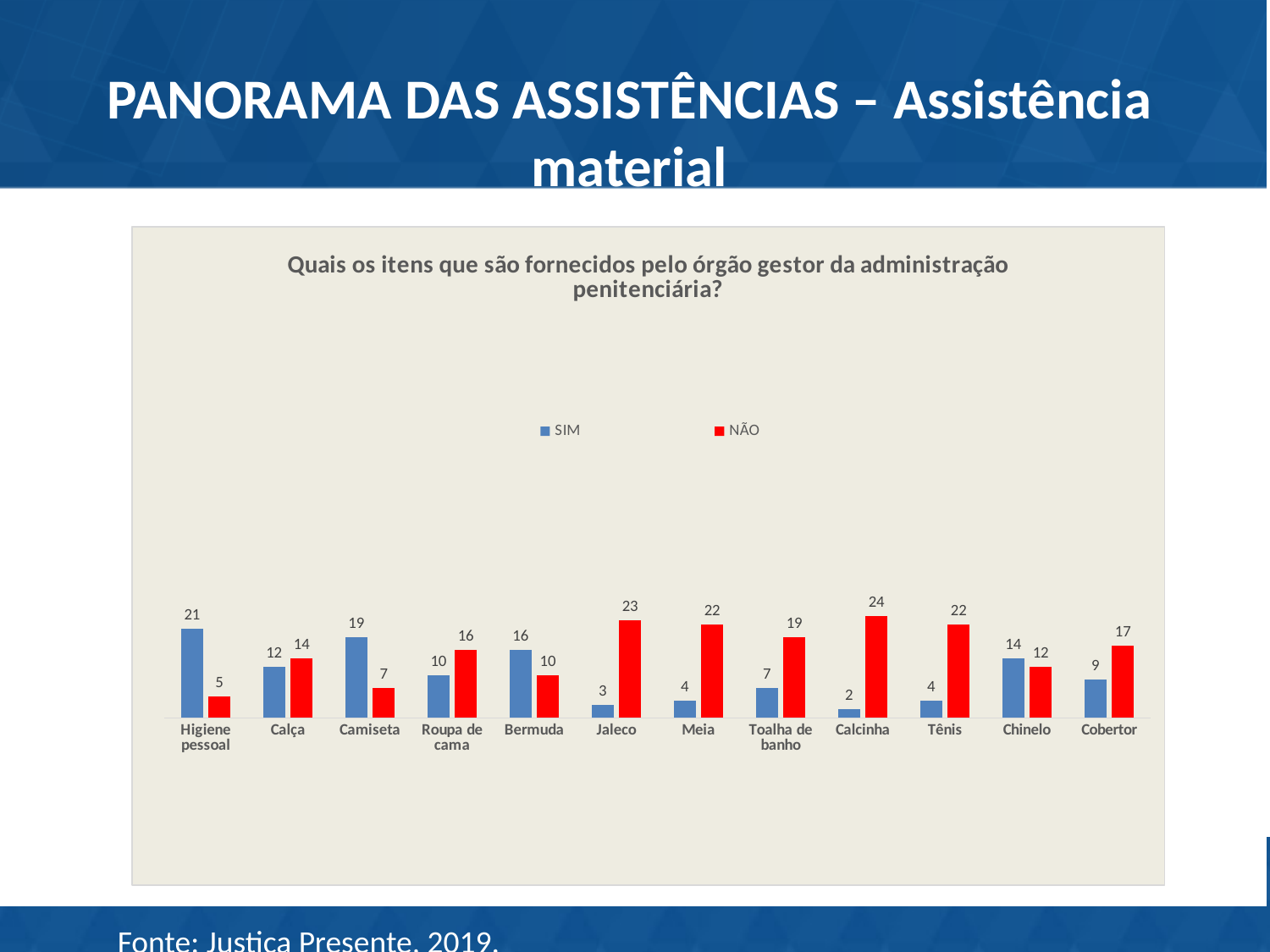
What is the NÃO value for Jaleco? 23 For Chinelo, which is larger, the SIM value or the NÃO value? SIM What is the total of the SIM and NÃO values for Cobertor? 26 Which category has the lowest SIM value? Calcinha How many categories are shown on the x axis? 12 What is the SIM value for Calcinha? 2 What kind of chart is shown on the slide? Bar chart How many series does the legend list? 2 What colour are the NÃO bars? Red Which category has the highest NÃO value? Calcinha What is the difference between the NÃO and SIM values for Meia? 18 What is the SIM value for Higiene pessoal? 21